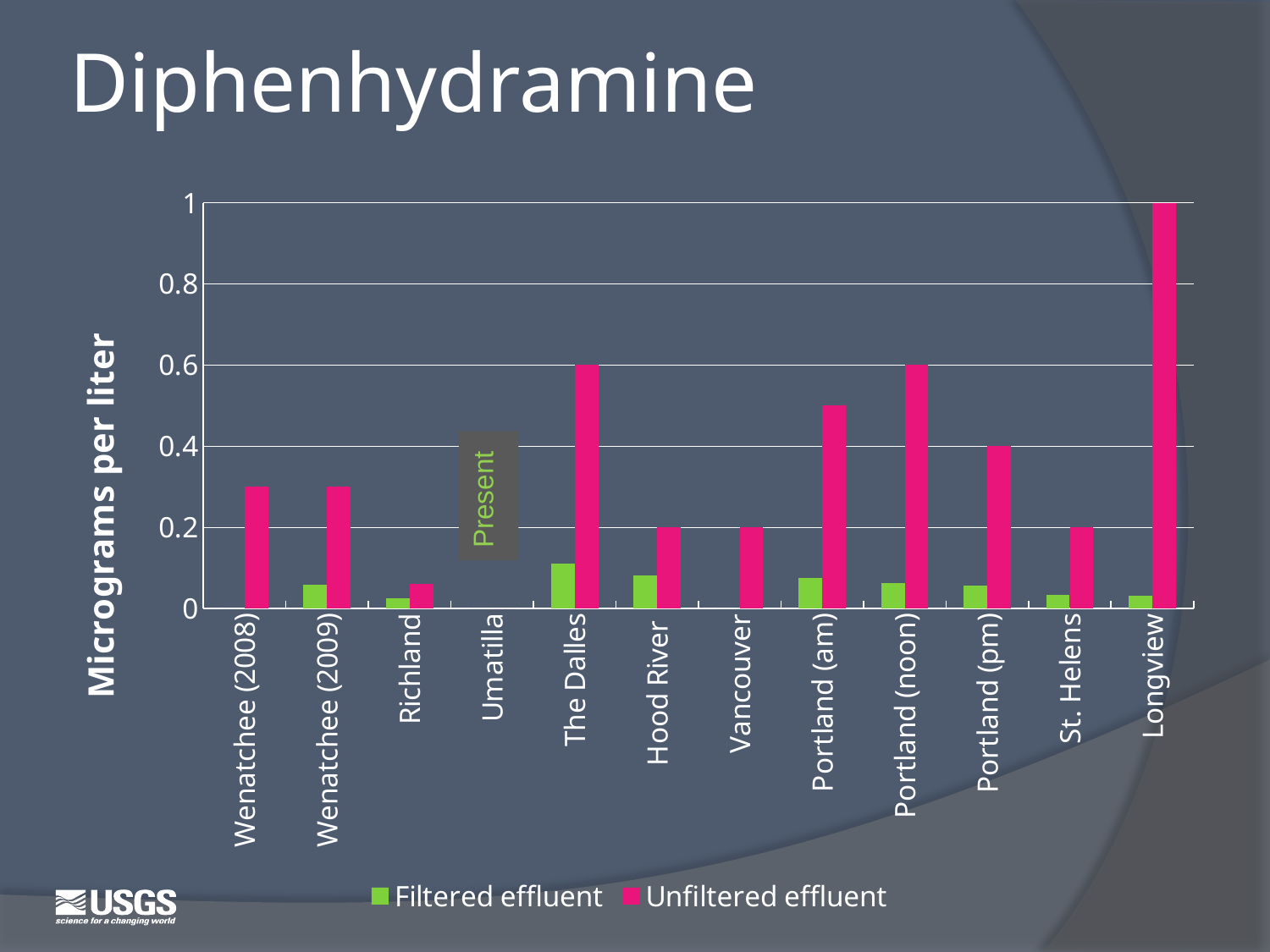
Which has the larger Unfiltered effluent value, Portland (noon) or Portland (pm)? Portland (noon) What is the Unfiltered effluent value for Longview? 1 Which category has the highest Filtered effluent value? The Dalles Is the Unfiltered effluent value for Wenatchee (2008) greater or less than 0.2? greater Which category has the highest Unfiltered effluent value? Longview How many series does the legend list? 2 What kind of chart is shown on the slide? bar chart What is the difference between the Unfiltered effluent values for Longview and The Dalles? 0.4 How many categories are shown along the x axis? 12 What is the title of the y axis? Micrograms per liter What is the Unfiltered effluent value for The Dalles? 0.6 What is the Unfiltered effluent value for Portland (pm)? 0.4